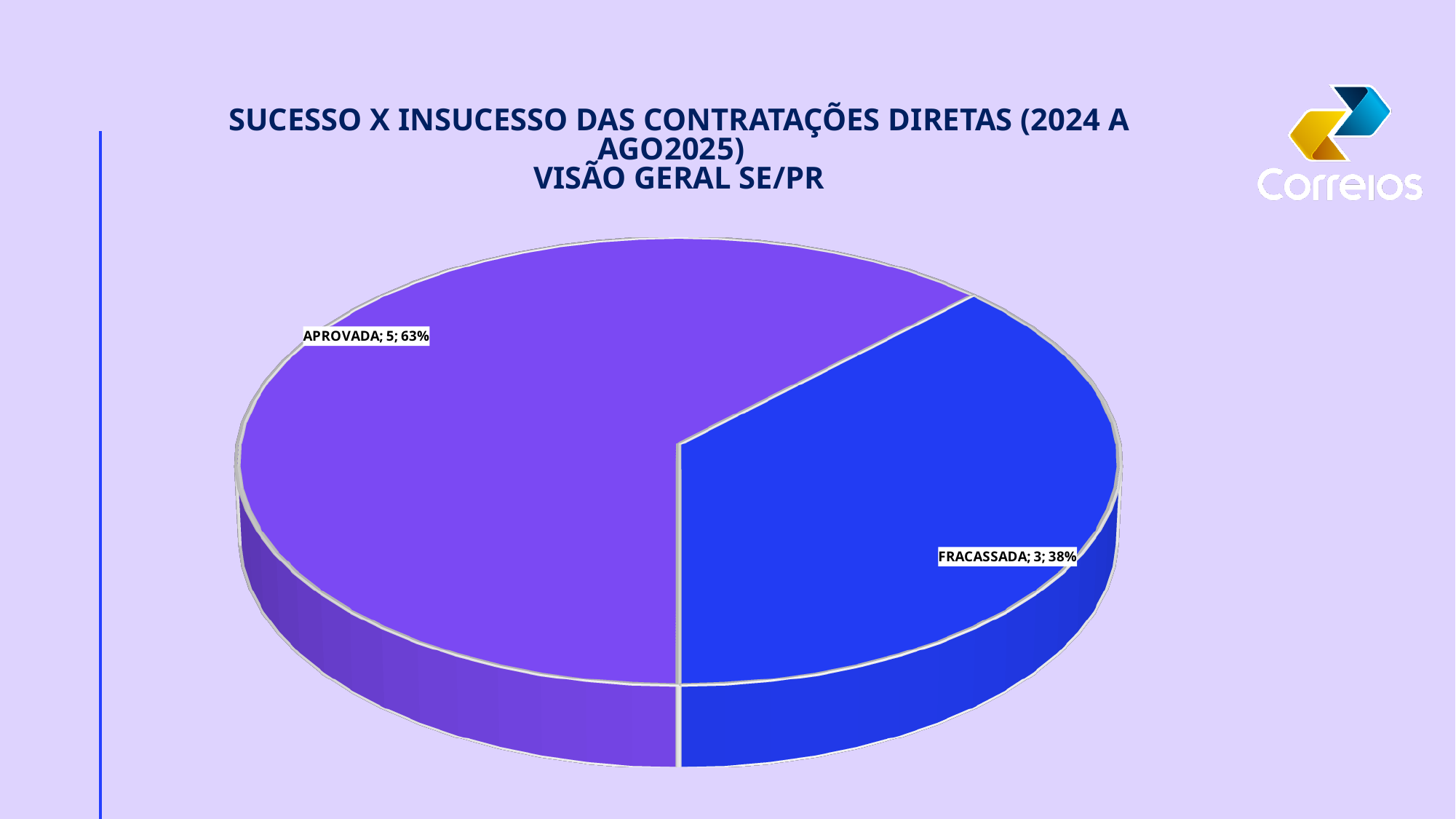
What is the value for FRACASSADA? 3 Which is larger, the value for APROVADA or the value for FRACASSADA? APROVADA What share of the pie does FRACASSADA represent? 38% How many slices does the pie chart have? 2 What is the value for APROVADA? 5 What share of the pie does APROVADA represent? 63% What kind of chart is shown on the slide? Pie chart Which category has the largest slice? APROVADA Which category has the smallest slice? FRACASSADA What colour is the FRACASSADA slice? Blue What is the total of the values for APROVADA and FRACASSADA? 8 What is the difference between the values for APROVADA and FRACASSADA? 2